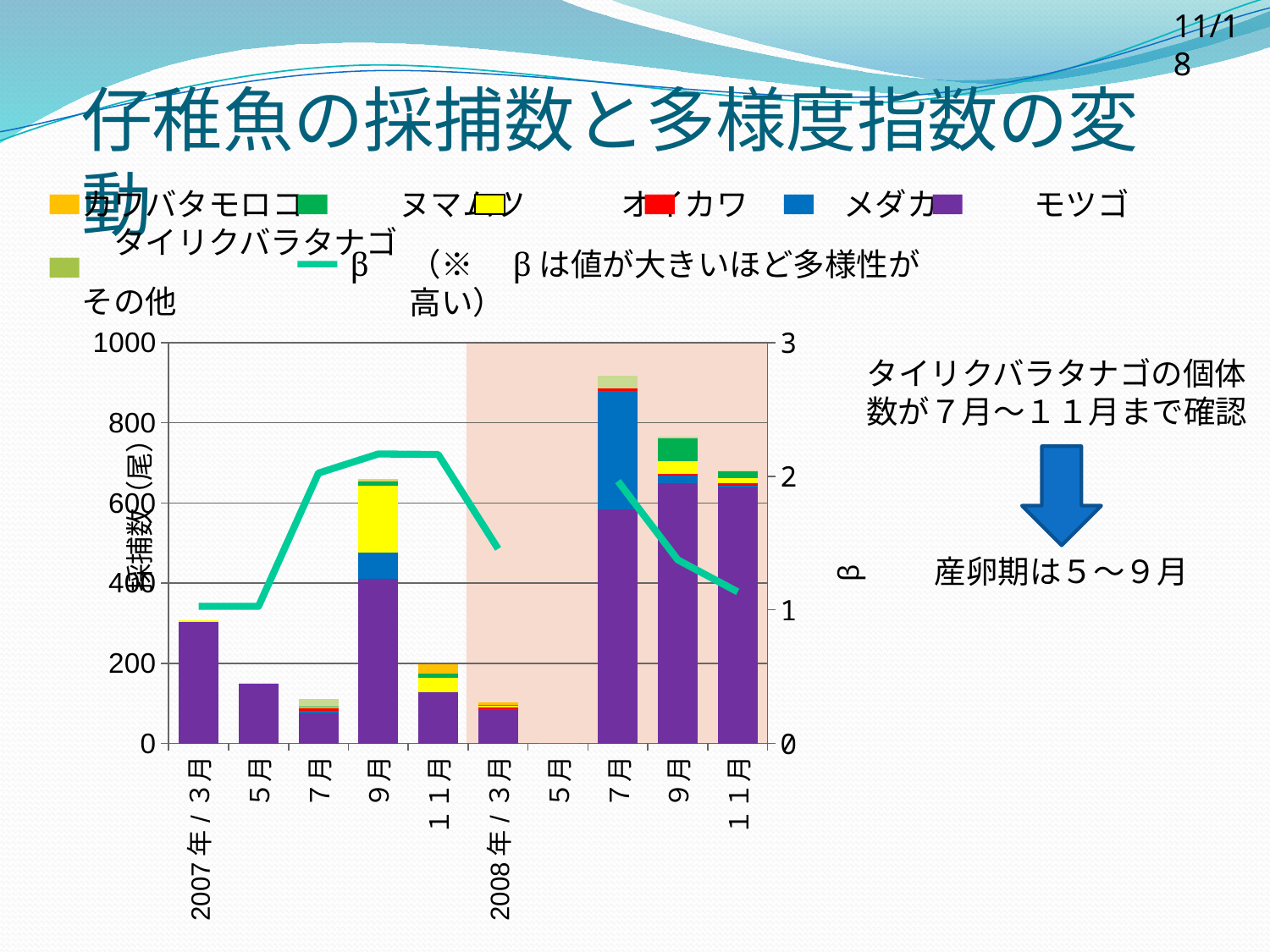
How many categories (sampling months) are shown on the x axis? 10 Which sampling month has the tallest stacked bar? 2008年/7月 What kind of chart is shown on the slide? bar chart (stacked, with a line for β) What is the label of the left vertical axis? 採捕数(尾) Which sampling month has the smallest total catch? 2008年/5月 Is the total catch for 2007年/3月 greater or less than 400? less Is the total catch for 2007年/5月 greater or less than 200? less Does the β line rise or fall from 2008年/7月 to 2008年/11月? fall Which has the larger total catch, 2007年/9月 or 2007年/11月? 2007年/9月 Is the total catch for 2008年/7月 greater or less than 800? greater How many series does the legend list? 8